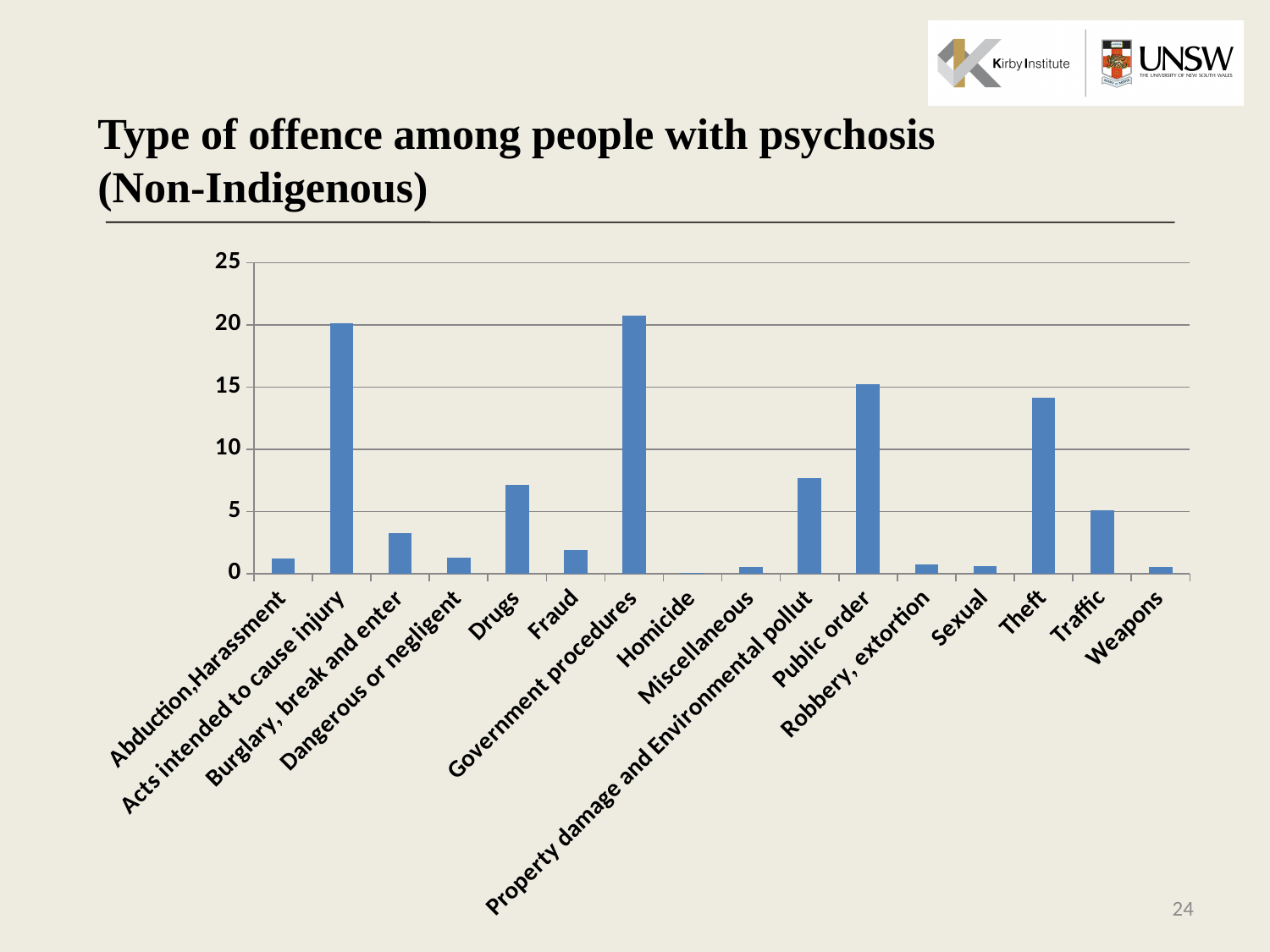
Is the value for Theft greater or less than 15? less Is the value for Acts intended to cause injury greater or less than 15? greater Which is larger, the value for Drugs or the value for Fraud? Drugs Is the value for Drugs greater or less than 5? greater How many offence categories are shown on the x axis? 16 Which offence category has the lowest value? Homicide What type of chart is shown on the slide? Bar chart What is the title of the chart on the slide? Type of offence among people with psychosis (Non-Indigenous) Which is larger, the value for Theft or the value for Traffic? Theft